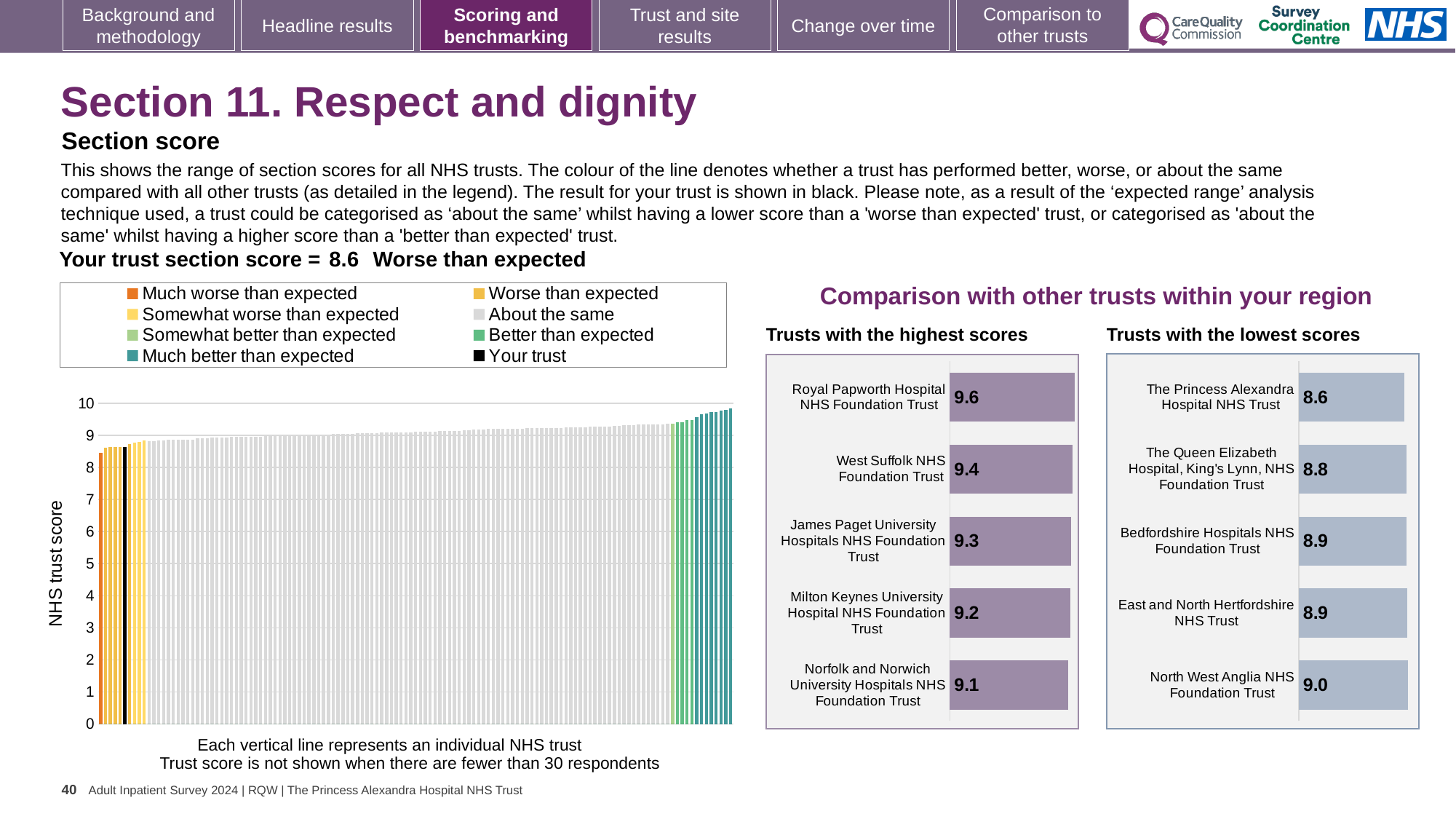
In the 'Trusts with the highest scores' chart, what is the score for Royal Papworth Hospital NHS Foundation Trust? 9.6 How many trusts are listed in the 'Trusts with the lowest scores' chart? 5 In the 'Trusts with the highest scores' chart, which has a higher score: West Suffolk NHS Foundation Trust or James Paget University Hospitals NHS Foundation Trust? West Suffolk NHS Foundation Trust What kind of chart is the large chart on the left showing NHS trust scores? Bar chart In the 'Trusts with the highest scores' chart, what is the difference between the scores of Royal Papworth Hospital NHS Foundation Trust and Norfolk and Norwich University Hospitals NHS Foundation Trust? 0.5 In the 'Trusts with the highest scores' chart, which trust has the highest score? Royal Papworth Hospital NHS Foundation Trust In the 'Trusts with the lowest scores' chart, what is the difference between the scores of North West Anglia NHS Foundation Trust and The Princess Alexandra Hospital NHS Trust? 0.4 In the 'Trusts with the highest scores' chart, what is the score for Milton Keynes University Hospital NHS Foundation Trust? 9.2 How many entries does the legend above the large chart on the left list? 8 In the 'Trusts with the lowest scores' chart, which trust has the lowest score? The Princess Alexandra Hospital NHS Trust In the large chart on the left, do the NHS trust scores rise or fall from left to right along the x axis? Rise In the 'Trusts with the lowest scores' chart, what is the score for The Queen Elizabeth Hospital, King's Lynn, NHS Foundation Trust? 8.8